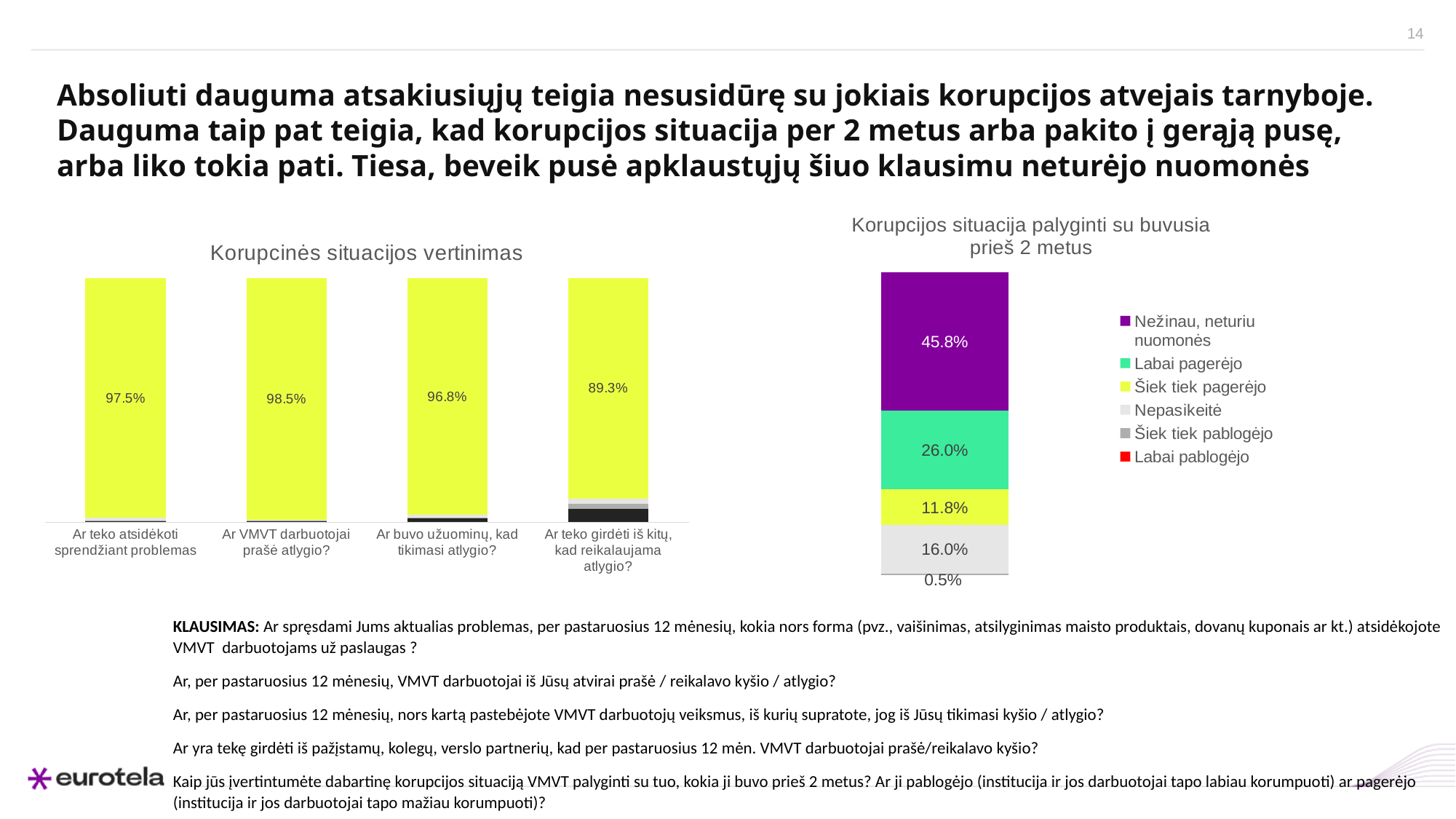
How many entries does the legend of the chart titled "Korupcijos situacija palyginti su buvusia prieš 2 metus" list? 6 How many categories are shown on the x axis of the chart titled "Korupcinės situacijos vertinimas"? 4 In the chart titled "Korupcinės situacijos vertinimas", what is the value of the yellow segment for "Ar teko atsidėkoti sprendžiant problemas"? 97.5% In the chart titled "Korupcinės situacijos vertinimas", which category has the highest labelled yellow value? Ar VMVT darbuotojai prašė atlygio? In the chart titled "Korupcinės situacijos vertinimas", what is the difference between the labelled values for "Ar VMVT darbuotojai prašė atlygio?" and "Ar teko girdėti iš kitų, kad reikalaujama atlygio?"? 9.2% What kind of chart is the chart titled "Korupcijos situacija palyginti su buvusia prieš 2 metus"? Stacked bar chart In the chart titled "Korupcinės situacijos vertinimas", which category has the lowest labelled yellow value? Ar teko girdėti iš kitų, kad reikalaujama atlygio? In the chart titled "Korupcijos situacija palyginti su buvusia prieš 2 metus", what is the value for "Nežinau, neturiu nuomonės"? 45.8% In the chart titled "Korupcinės situacijos vertinimas", what is the value of the yellow segment for "Ar VMVT darbuotojai prašė atlygio?"? 98.5% In the chart titled "Korupcinės situacijos vertinimas", what is the value of the yellow segment for "Ar teko girdėti iš kitų, kad reikalaujama atlygio?"? 89.3% In the chart titled "Korupcijos situacija palyginti su buvusia prieš 2 metus", which is larger: "Šiek tiek pagerėjo" or "Nepasikeitė"? Nepasikeitė In the chart titled "Korupcijos situacija palyginti su buvusia prieš 2 metus", what is the value for "Labai pagerėjo"? 26.0%